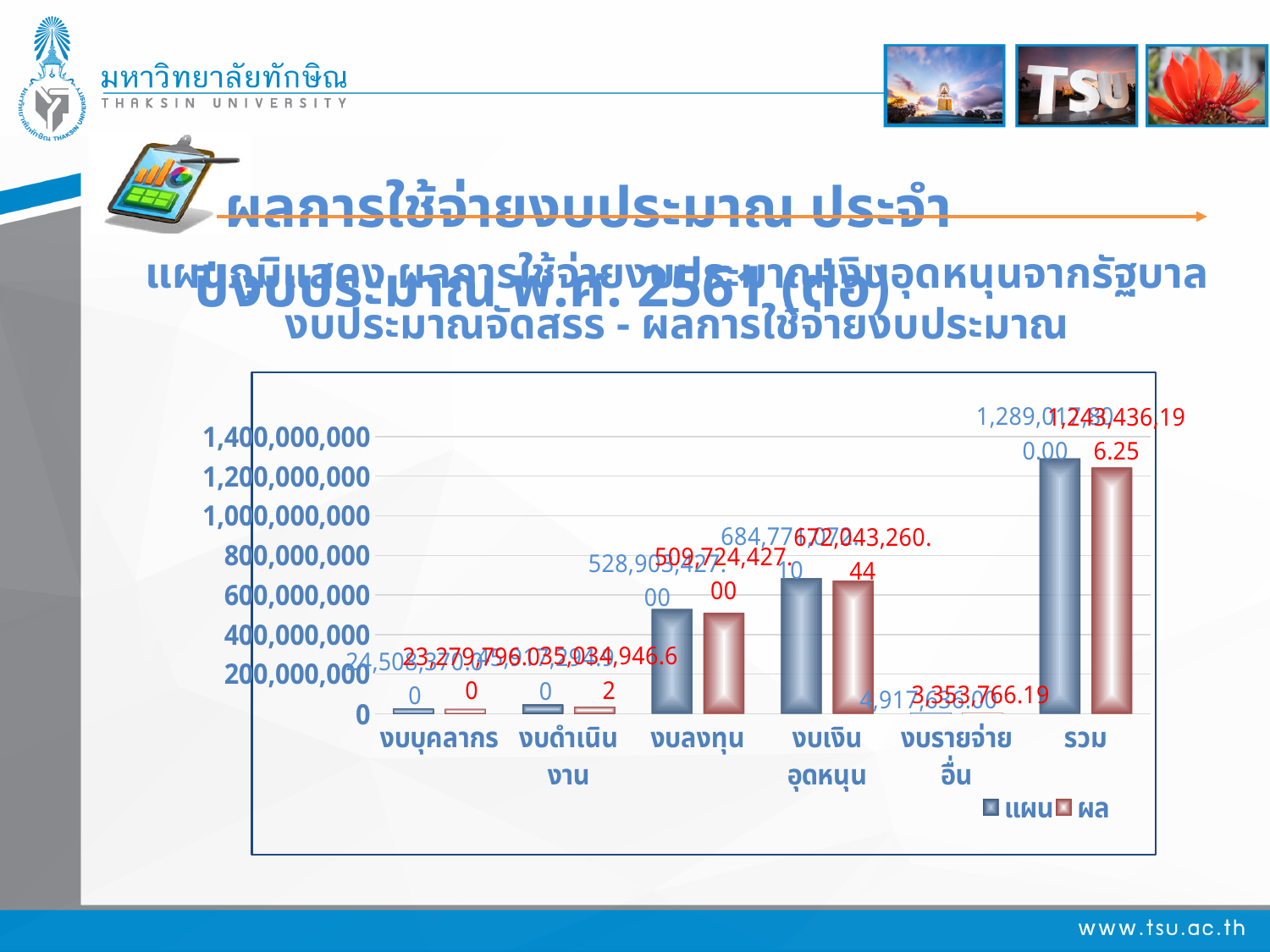
For the แผน series, which is larger: งบเงินอุดหนุน or งบลงทุน? งบเงินอุดหนุน What is the ผล value for งบเงินอุดหนุน? 672,043,260.44 How many series does the legend list? 2 What are the two legend entries of the chart? แผน and ผล Which category has the highest value for the แผน series? รวม How many categories are shown on the x axis? 6 Which category has the lowest value for the ผล series? งบรายจ่ายอื่น What is the ผล value for งบรายจ่ายอื่น? 3,353,766.19 Is the แผน value for งบลงทุน greater or less than 400,000,000? greater What is the ผล value for งบลงทุน? 509,724,427.00 Is the แผน value for รวม greater or less than 1,200,000,000? greater What kind of chart is shown on the slide? bar chart